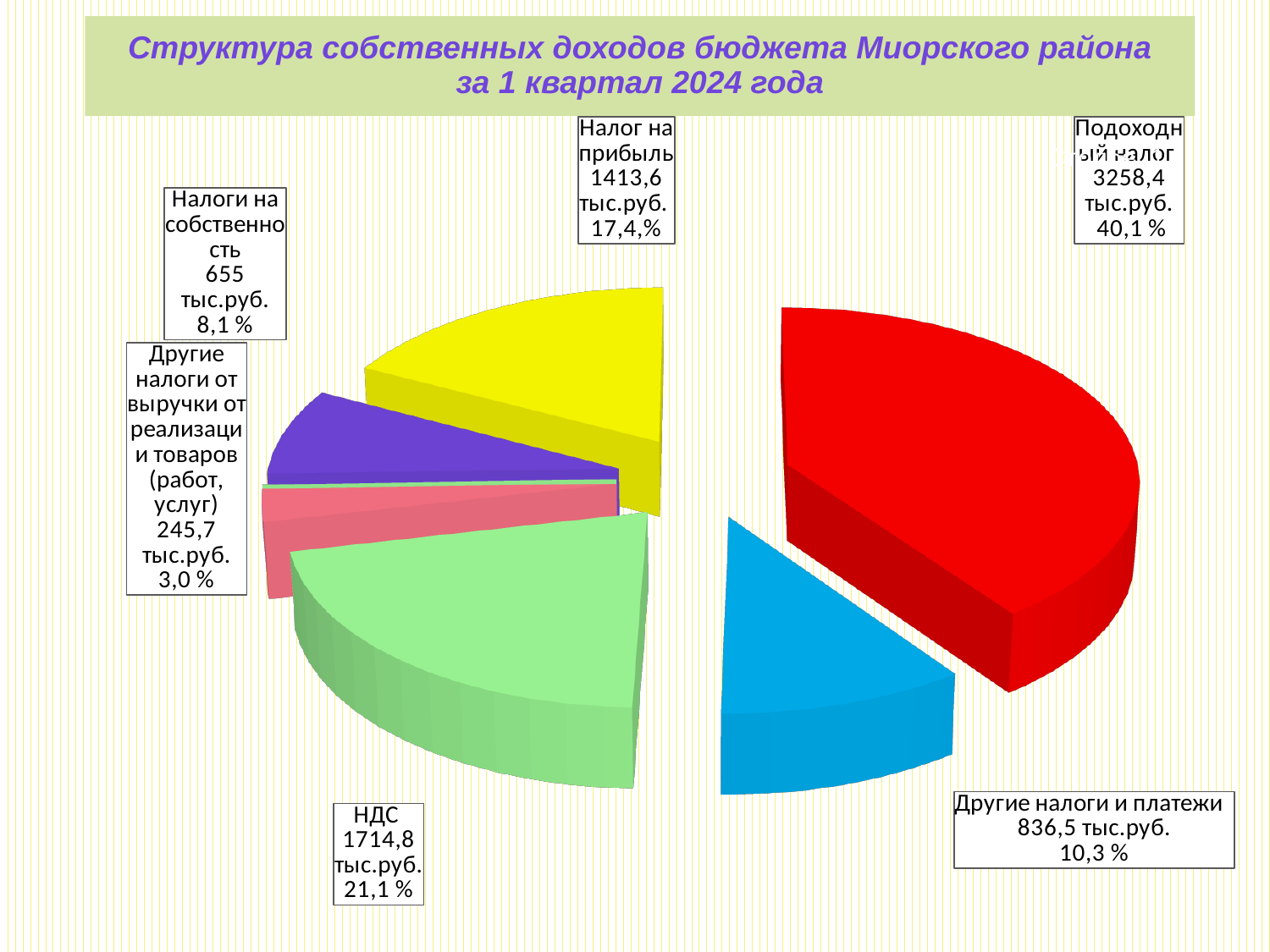
What percentage is shown for Налог на прибыль? 17,4,% Which is larger, НДС or Налог на прибыль? НДС What is the difference in value between Подоходный налог and НДС? 1543,6 тыс.руб. What is the value shown for Налоги на собственность? 655 тыс.руб. What percentage is shown for Другие налоги и платежи? 10,3 % What type of chart is shown on the slide? pie chart What is the value shown for Подоходный налог? 3258,4 тыс.руб. Which category has the largest share of the pie? Подоходный налог What is the title of the chart? Структура собственных доходов бюджета Миорского района за 1 квартал 2024 года What is the value shown for НДС? 1714,8 тыс.руб. What share of the pie does Подоходный налог represent? 40,1 %